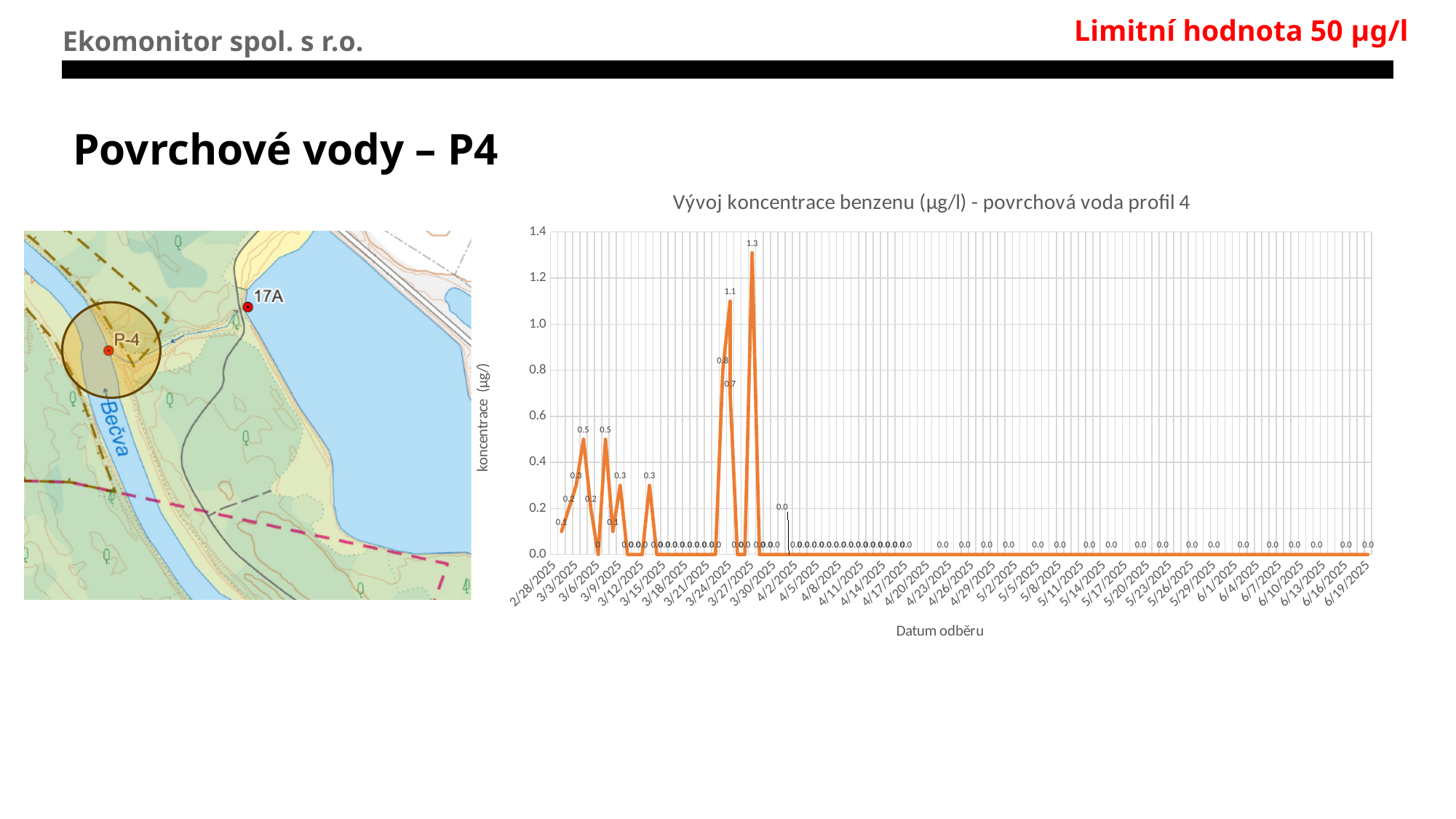
What is the lowest value labelled on the chart? 0.0 Is the highest peak on the chart greater or less than 1.0? greater What is the label of the vertical axis of the chart? koncentrace (µg/l) What is the title of the chart? Vývoj koncentrace benzenu (µg/l) - povrchová voda profil 4 What is the difference between the two highest labelled peaks, 1.3 and 1.1? 0.2 What is the highest benzene concentration value labelled on the chart? 1.3 How many data series are plotted on the chart? 1 Do the concentration values rise or fall along the x axis after the end of March 2025? neither – they stay flat at 0.0 What is the last date shown on the x axis of the chart? 6/19/2025 Which is larger: the peak labelled 0.8 or the peak labelled 0.7? 0.8 What is the concentration value labelled at the first date, 2/28/2025? 0.1 What kind of chart is shown on the slide? line chart